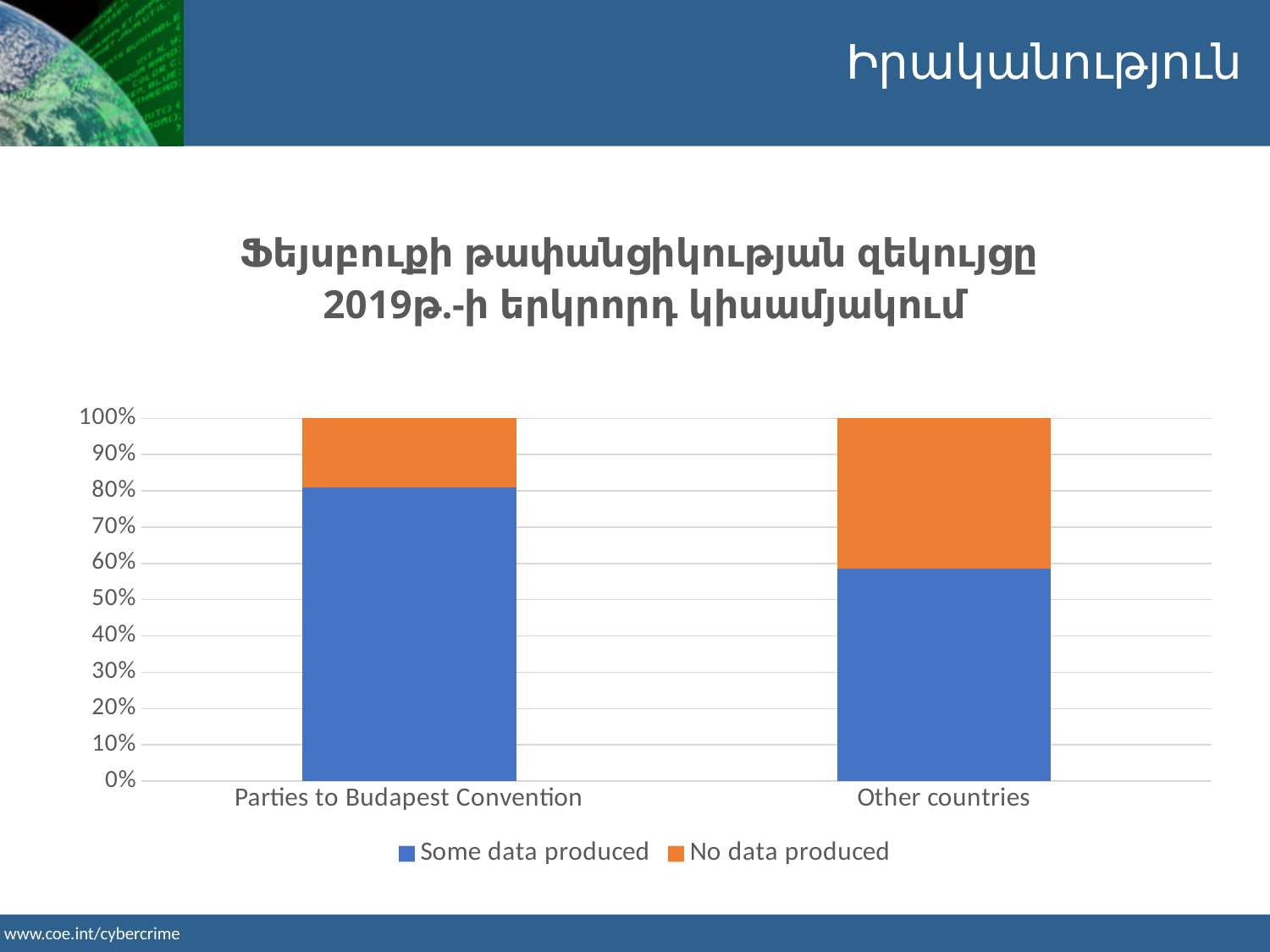
How many series does the chart legend list? 2 Is the 'No data produced' share for Other countries greater or less than 30%? greater Is the 'Some data produced' share for Parties to Budapest Convention greater or less than 70%? greater Which category has the highest 'No data produced' share? Other countries What are the two series listed in the chart legend? Some data produced; No data produced How many categories are shown on the x axis of the chart? 2 What is the total height of the stacked bar for Other countries? 100% Which category has the larger 'Some data produced' share: Parties to Budapest Convention or Other countries? Parties to Budapest Convention Is the 'No data produced' share for Parties to Budapest Convention greater or less than 30%? less What kind of chart is shown on the slide? Stacked bar chart Which colour represents 'No data produced' in the chart? Orange